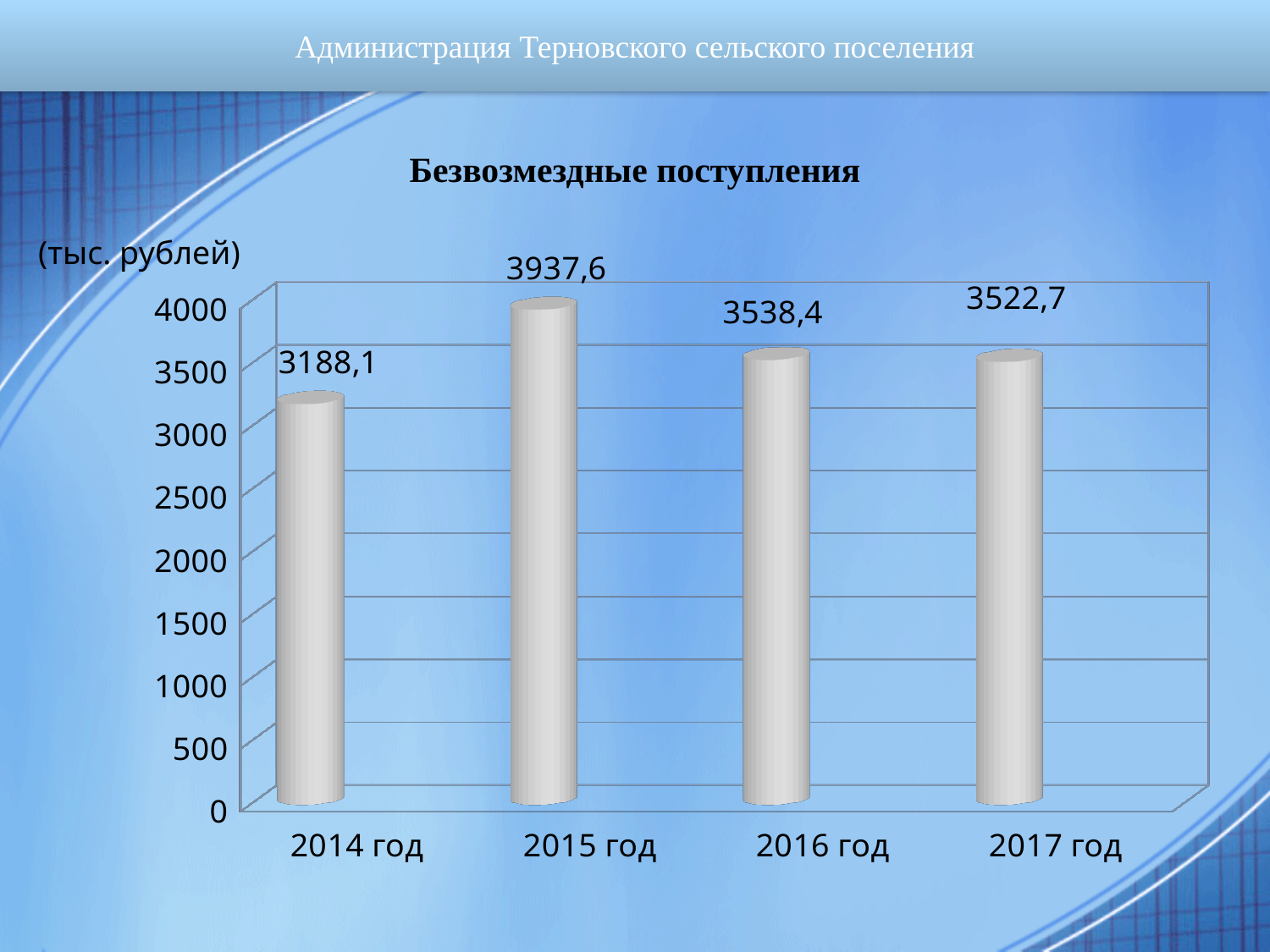
Which is larger, the value for 2016 год or the value for 2017 год? 2016 год What is the value for 2017 год? 3522,7 What kind of chart is shown on the slide? bar chart Which year has the highest value? 2015 год What is the value for 2014 год? 3188,1 Is the value for 2014 год greater or less than 3500? less What is the value for 2015 год? 3937,6 What is the title of the chart? Безвозмездные поступления What is the difference between the values for 2016 год and 2017 год? 15,7 Which year has the lowest value? 2014 год How many years are shown on the x axis? 4 What is the difference between the values for 2015 год and 2014 год? 749,5